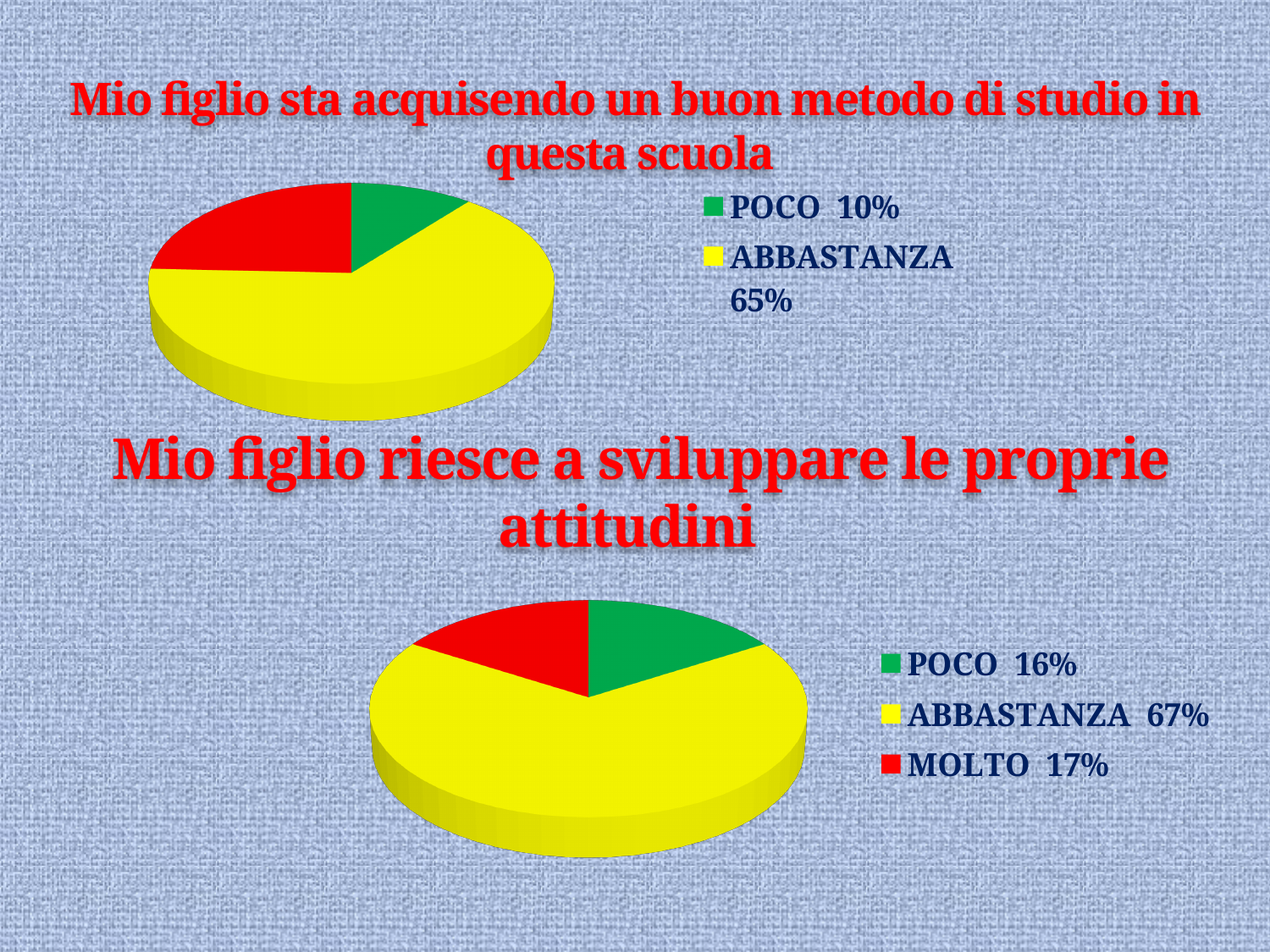
What type of chart is used on this slide for 'Mio figlio riesce a sviluppare le proprie attitudini'? Pie chart In the bottom chart 'Mio figlio riesce a sviluppare le proprie attitudini', which category has the smallest share? POCO What colour represents ABBASTANZA in the bottom chart 'Mio figlio riesce a sviluppare le proprie attitudini'? Yellow In the bottom chart 'Mio figlio riesce a sviluppare le proprie attitudini', what is the difference between the ABBASTANZA and POCO percentages? 51% In the top chart 'Mio figlio sta acquisendo un buon metodo di studio in questa scuola', what percentage is shown for POCO? 10% How many categories does the legend of the bottom chart 'Mio figlio riesce a sviluppare le proprie attitudini' list? 3 In the bottom chart 'Mio figlio riesce a sviluppare le proprie attitudini', which is larger, POCO or MOLTO? MOLTO In the top chart 'Mio figlio sta acquisendo un buon metodo di studio in questa scuola', what percentage is shown for ABBASTANZA? 65% In the bottom chart 'Mio figlio riesce a sviluppare le proprie attitudini', which category has the largest share? ABBASTANZA In the bottom chart 'Mio figlio riesce a sviluppare le proprie attitudini', what percentage is shown for ABBASTANZA? 67% In the top chart 'Mio figlio sta acquisendo un buon metodo di studio in questa scuola', which is larger, POCO or ABBASTANZA? ABBASTANZA In the bottom chart 'Mio figlio riesce a sviluppare le proprie attitudini', what percentage is shown for MOLTO? 17%